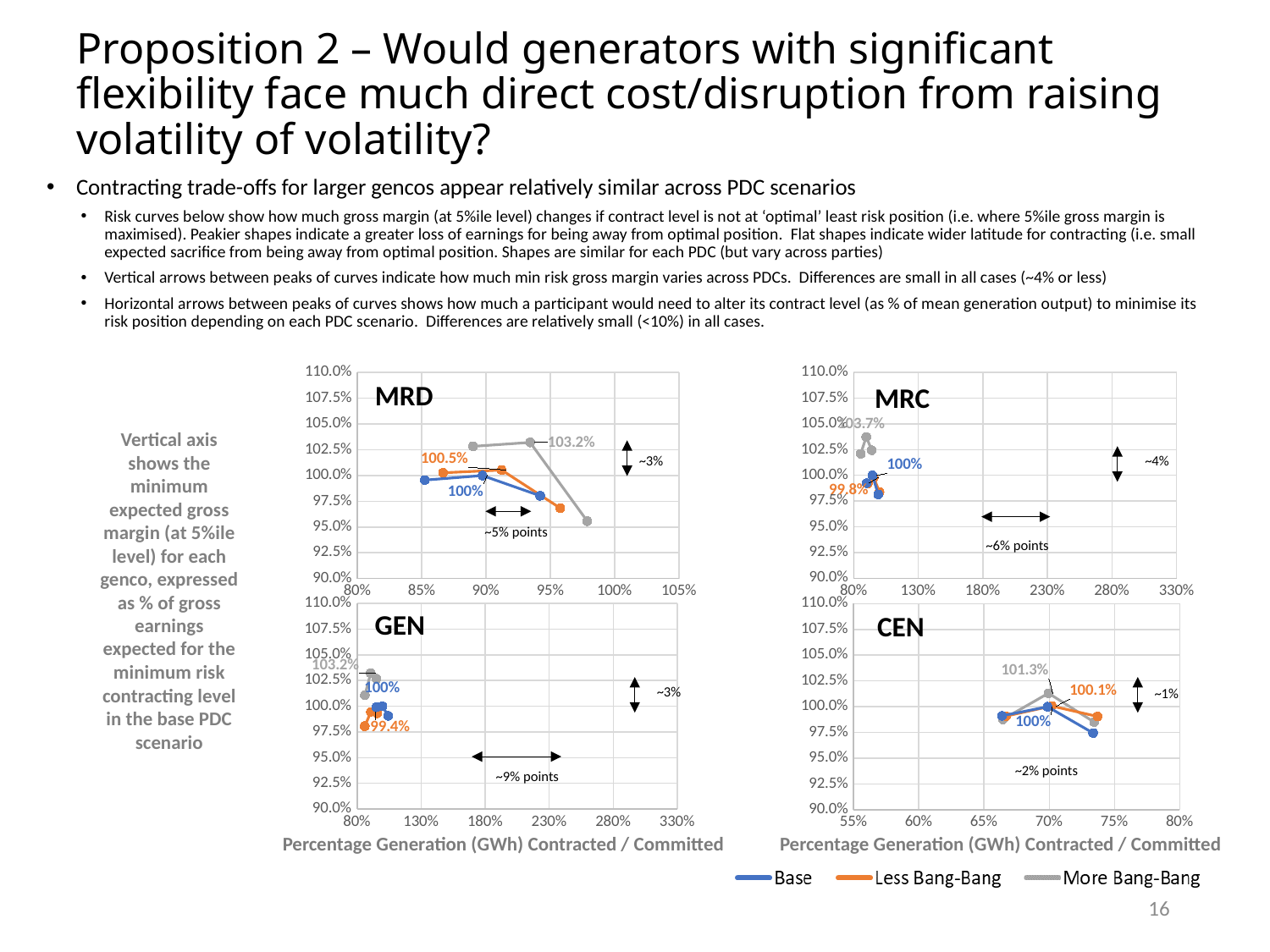
In the MRD chart, which series has the highest labelled peak value? More Bang-Bang What kind of chart is the CEN chart? Line chart In the MRC chart, what is the labelled peak value for the More Bang-Bang series? 103.7% In the CEN chart, what is the labelled peak value for the More Bang-Bang series? 101.3% How many series does the legend list for the charts? 3 In the MRC chart, what is the labelled peak value for the Less Bang-Bang series? 99.8% In the GEN chart, which series has the lowest labelled peak value? Less Bang-Bang In the MRD chart, what is the labelled peak value for the More Bang-Bang series? 103.2% In the CEN chart, what is the labelled peak value for the Less Bang-Bang series? 100.1% In the MRD chart, what is the labelled peak value for the Less Bang-Bang series? 100.5% In the MRC chart, what is the difference between the labelled peak values of the More Bang-Bang and Base series? 3.7% In the GEN chart, what is the labelled peak value for the Less Bang-Bang series? 99.4%